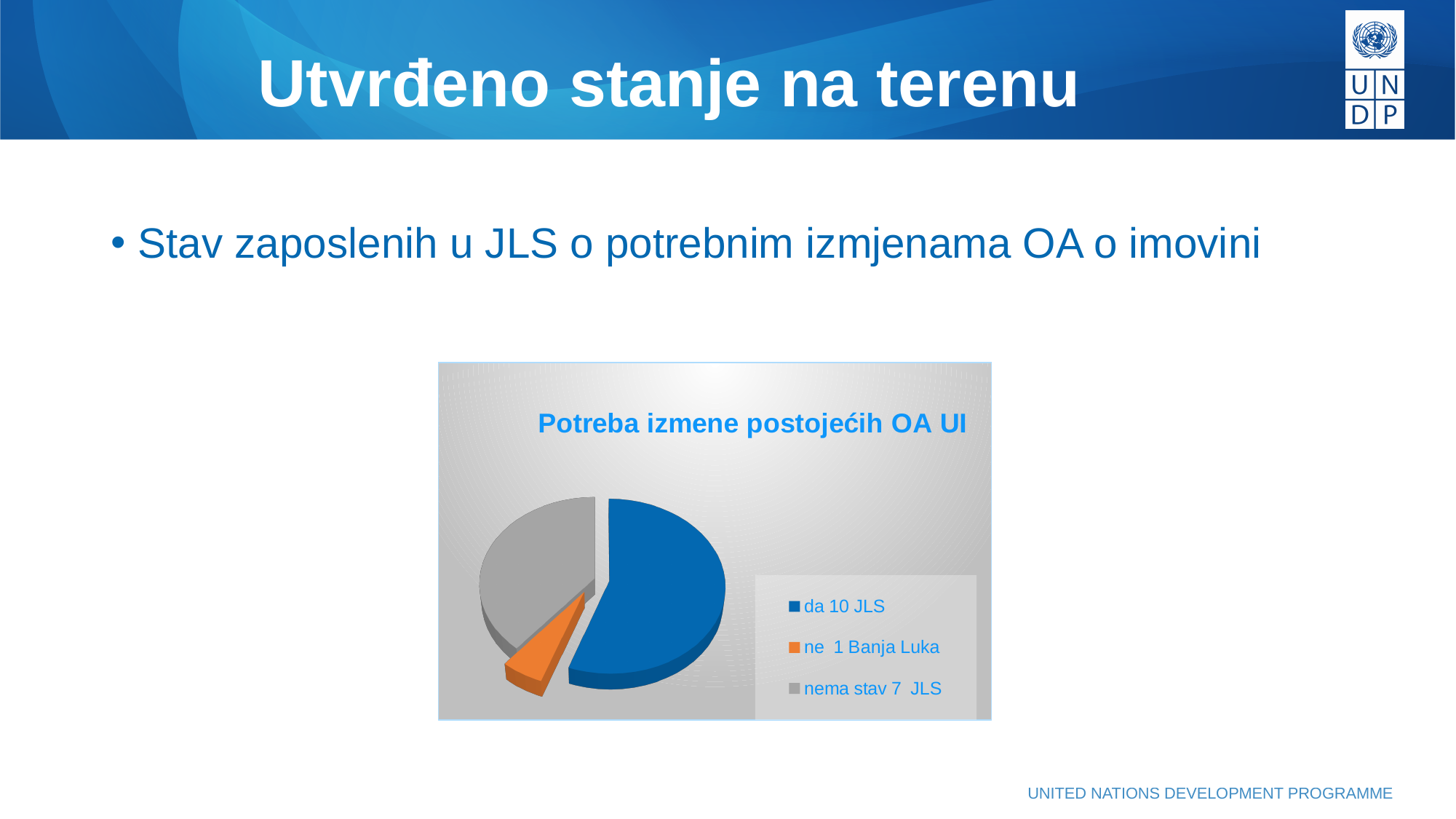
According to the legend, how many JLS answered "nema stav"? 7 What is the difference between the number of JLS that answered "da" and those with "nema stav"? 3 Which legend entry corresponds to the largest slice of the pie? da 10 JLS What type of chart is shown on the slide? pie chart Which legend entry corresponds to the smallest slice of the pie? ne 1 Banja Luka What colour is the slice for "ne 1 Banja Luka"? orange How many slices does the pie chart have? 3 According to the legend, how many answered "ne"? 1 According to the legend, how many JLS answered "da"? 10 How many entries does the chart legend list? 3 Which is larger: the "da" slice or the "nema stav" slice? da What is the title of the chart? Potreba izmene postojećih OA UI